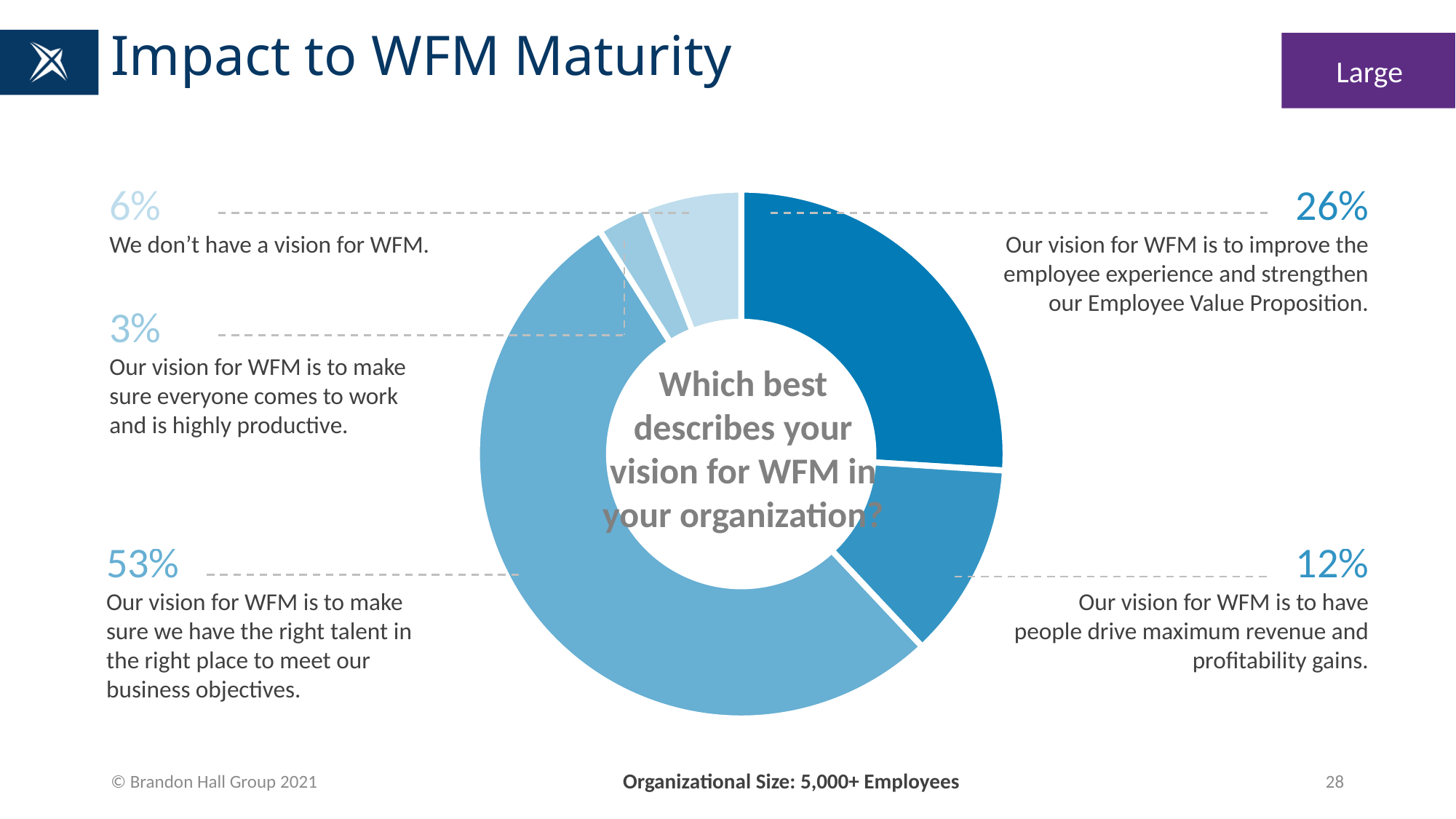
Which response has the smallest share of the chart? Our vision for WFM is to make sure everyone comes to work and is highly productive. What is the difference in percentage points between the 'right talent in the right place' response and the 'improve the employee experience' response? 27 Which response has the largest share of the chart? Our vision for WFM is to make sure we have the right talent in the right place to meet our business objectives. What question is written in the center of the chart? Which best describes your vision for WFM in your organization? What percentage of respondents said their vision for WFM is to make sure they have the right talent in the right place to meet business objectives? 53% What percentage of respondents said their vision for WFM is to improve the employee experience and strengthen their Employee Value Proposition? 26% What percentage of respondents said they don't have a vision for WFM? 6% What kind of chart is shown on the slide? Donut (pie) chart How many response categories are shown in the chart? 5 What percentage of respondents said their vision for WFM is to have people drive maximum revenue and profitability gains? 12% What percentage of respondents said their vision for WFM is to make sure everyone comes to work and is highly productive? 3% Which is larger: the share for 'drive maximum revenue and profitability gains' or the share for 'We don't have a vision for WFM'? Our vision for WFM is to have people drive maximum revenue and profitability gains.